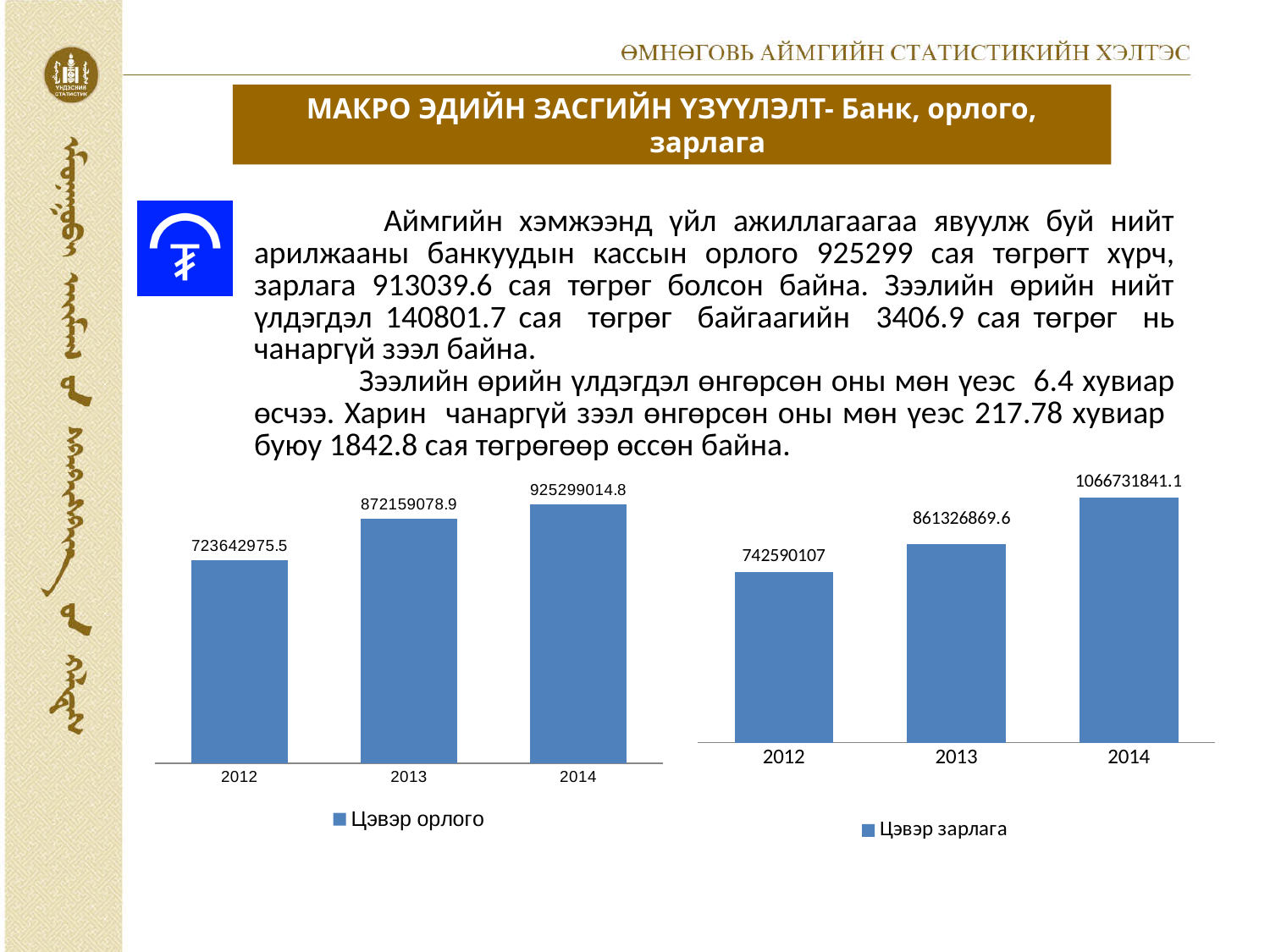
In the right chart (Цэвэр зарлага), what is the value for 2014? 1066731841.1 In the right chart (Цэвэр зарлага), what is the difference between the 2014 and 2013 values? 205404971.5 How many bars are in the left chart (Цэвэр орлого)? 3 In the right chart (Цэвэр зарлага), what is the value for 2013? 861326869.6 In the right chart (Цэвэр зарлага), which year has the lowest value? 2012 In the right chart (Цэвэр зарлага), which is larger: the value for 2012 or the value for 2013? 2013 What type of chart is the right chart (Цэвэр зарлага)? Bar chart In the left chart (Цэвэр орлого), which year has the highest value? 2014 In the left chart (Цэвэр орлого), what is the difference between the 2014 and 2012 values? 201656039.3 In the left chart (Цэвэр орлого), what is the value for 2014? 925299014.8 In the left chart (Цэвэр орлого), what is the value for 2012? 723642975.5 In the right chart (Цэвэр зарлага), do the values rise or fall from 2012 to 2014? Rise